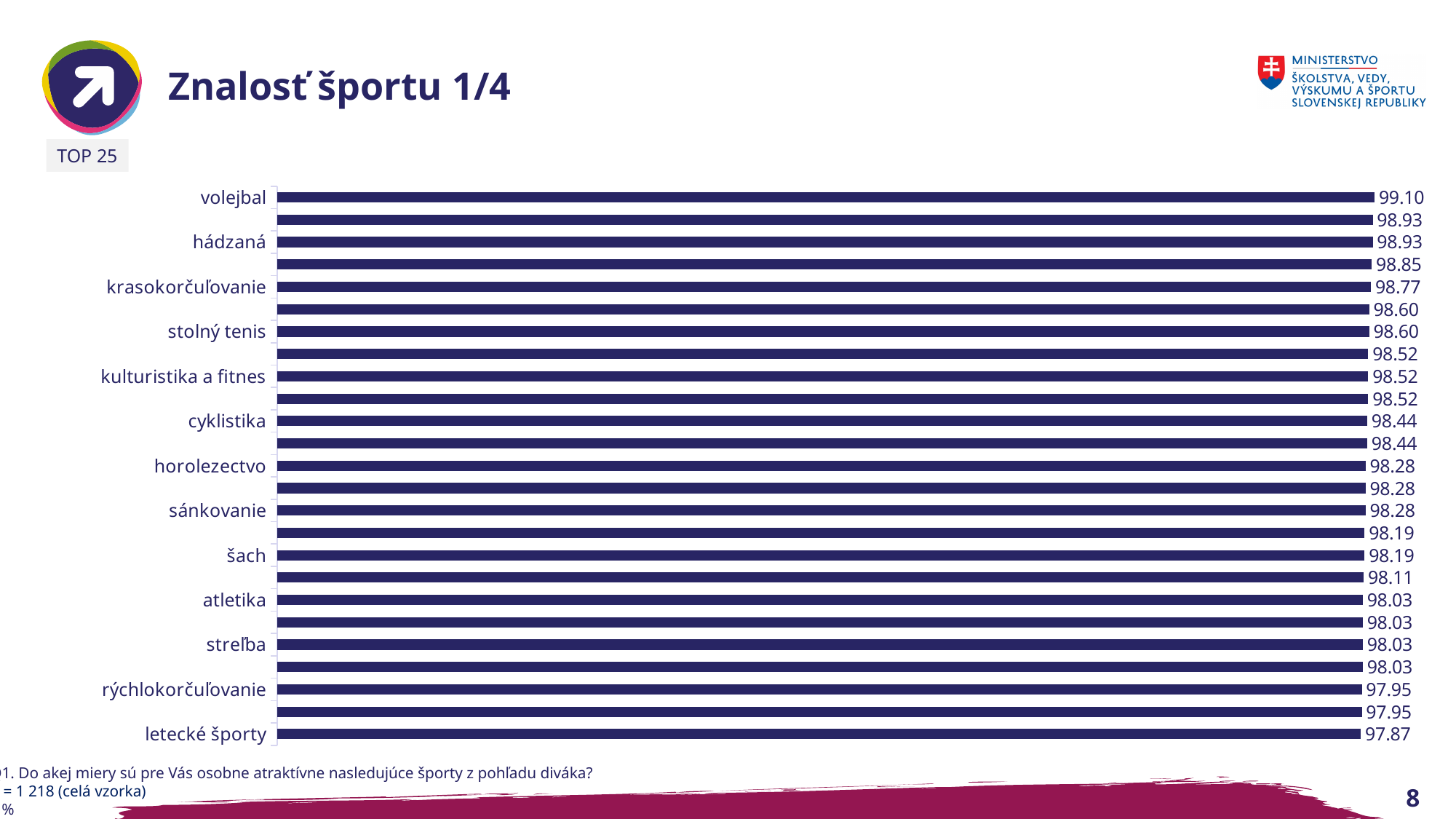
What value is shown for letecké športy? 97.87 Which labeled category has the highest value? volejbal Which has a higher value, stolný tenis or atletika? stolný tenis What value is shown for šach? 98.19 Which labeled category has the lowest value? letecké športy What kind of chart is shown on the slide? bar chart What is the title of the slide? Znalosť športu 1/4 What is the difference between the values for volejbal and letecké športy? 1.23 What value is shown for volejbal? 99.10 What is the difference between the values for hádzaná and šach? 0.74 How many bars are plotted in the chart? 25 What value is shown for krasokorčuľovanie? 98.77